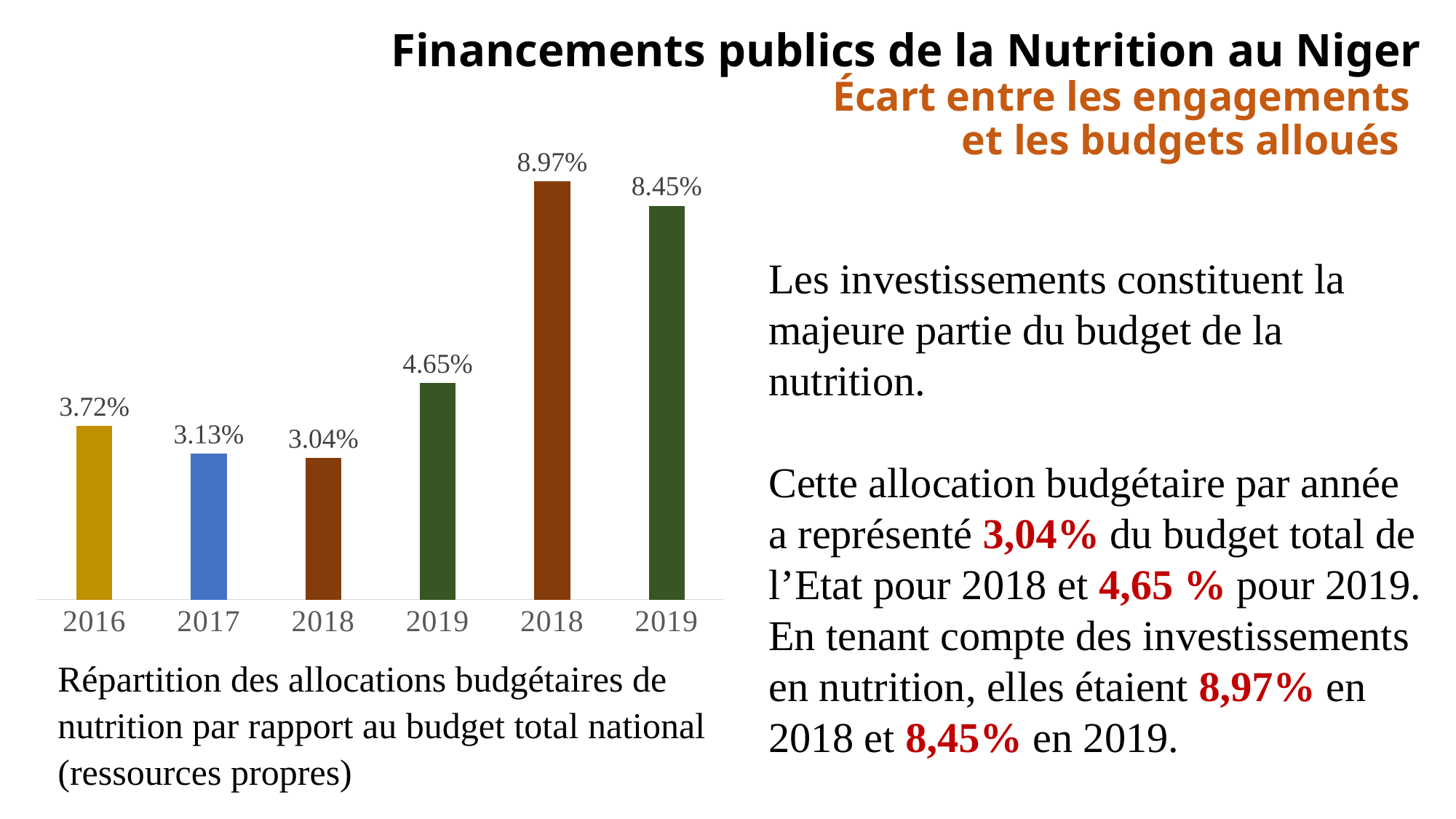
How many bars are plotted on the chart? 6 What is the highest value shown on the chart? 8.97% What is the value shown on the first (left-hand) 2018 bar? 3.04% What is the value shown for 2016? 3.72% What is the value shown on the second (right-hand) 2019 bar? 8.45% What is the value shown on the first (left-hand) 2019 bar? 4.65% What kind of chart is shown on the slide? Bar chart Which is larger, the value for 2016 or the value for 2017? 2016 What is the value shown for 2017? 3.13% What is the difference between the 2016 value and the 2017 value? 0.59% What is the value shown on the second (right-hand) 2018 bar? 8.97% What is the lowest value shown on the chart? 3.04%